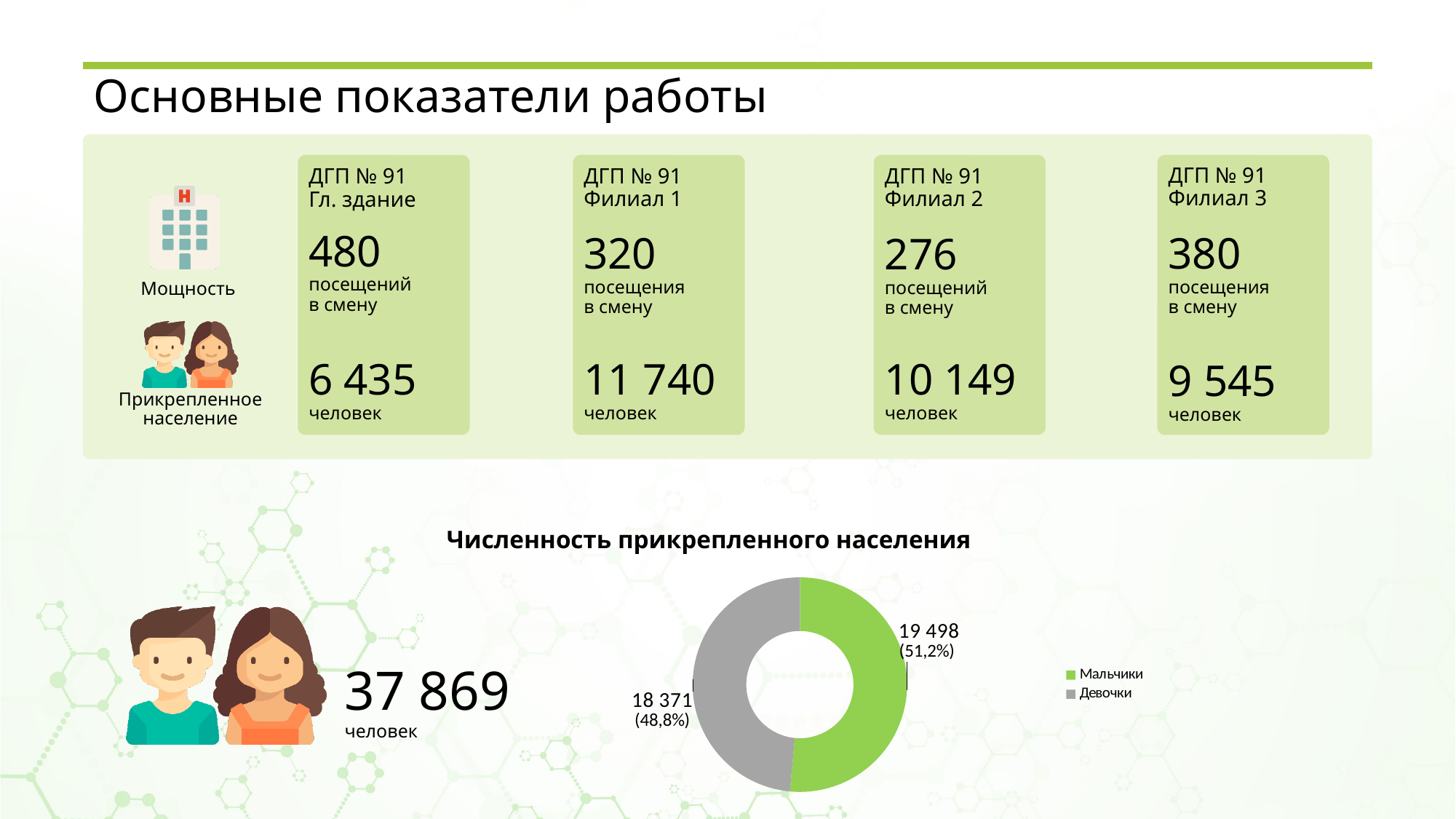
How many entries does the legend of the chart "Численность прикрепленного населения" list? 2 How many categories does the chart "Численность прикрепленного населения" show? 2 In the chart "Численность прикрепленного населения", what share of the pie does Девочки take? 48,8% In the chart "Численность прикрепленного населения", which category has the larger value, Мальчики or Девочки? Мальчики In the chart "Численность прикрепленного населения", which category has the smallest value? Девочки In the chart "Численность прикрепленного населения", what is the difference between the values for Мальчики and Девочки? 1 127 In the chart "Численность прикрепленного населения", what share of the pie does Мальчики take? 51,2% What is the title of the chart on the slide? Численность прикрепленного населения In the chart "Численность прикрепленного населения", what is the value for Мальчики? 19 498 What kind of chart is shown under the title "Численность прикрепленного населения"? pie chart (donut) In the chart "Численность прикрепленного населения", which colour represents Девочки? grey In the chart "Численность прикрепленного населения", what is the value for Девочки? 18 371